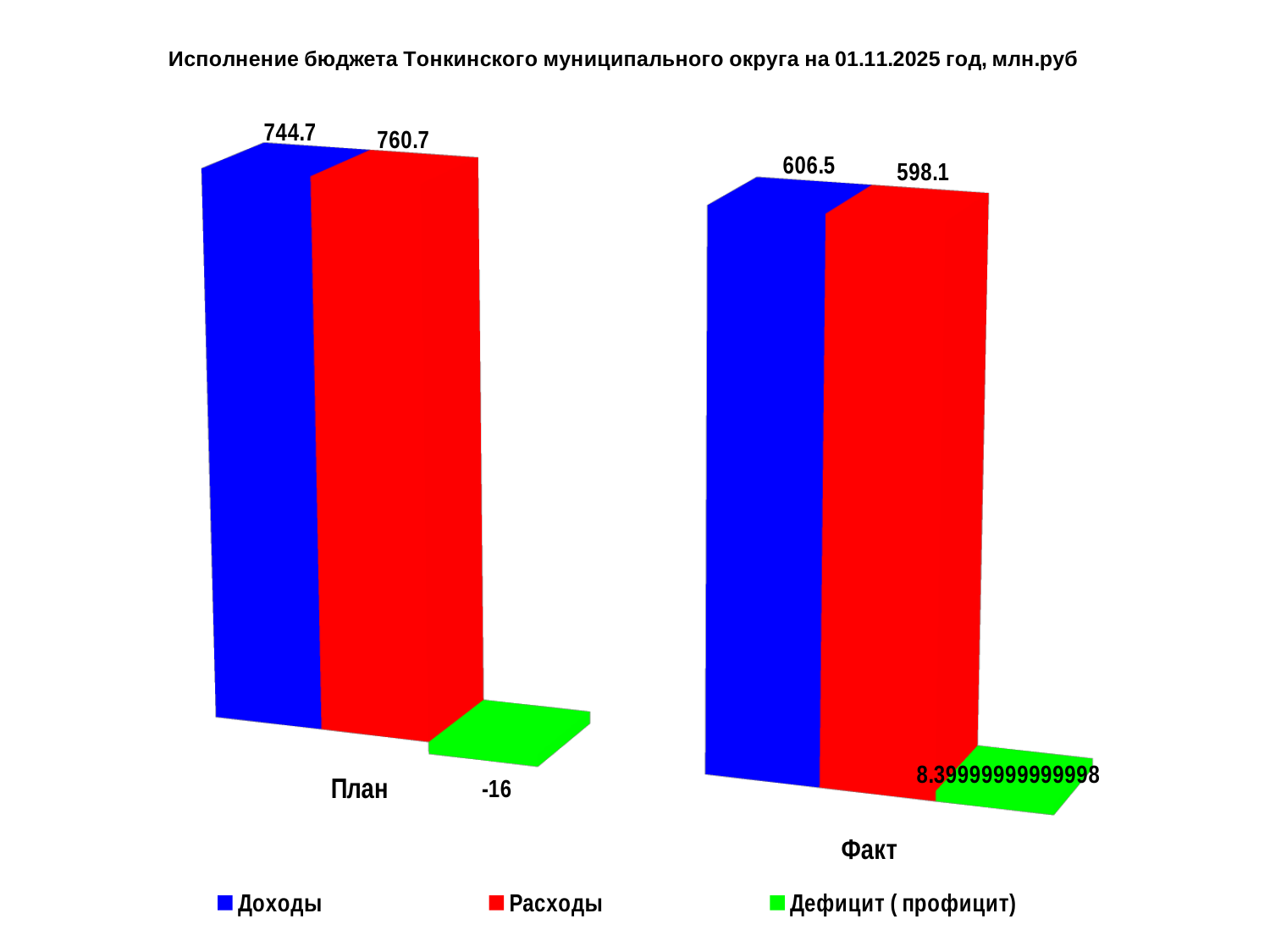
What is the value of Доходы for Факт? 606.5 What is the value of Дефицит (профицит) for План? -16 What is the difference between Доходы for План and Доходы for Факт? 138.2 What is the value of Расходы for План? 760.7 How many series does the legend list? 3 Which is larger for План: Доходы or Расходы? Расходы What is the value of Дефицит (профицит) for Факт? 8.39999999999998 What kind of chart is shown on the slide? Bar chart What is the difference between Расходы for План and Расходы for Факт? 162.6 Which is larger for Факт: Доходы or Расходы? Доходы What is the value of Доходы for План? 744.7 What is the value of Расходы for Факт? 598.1